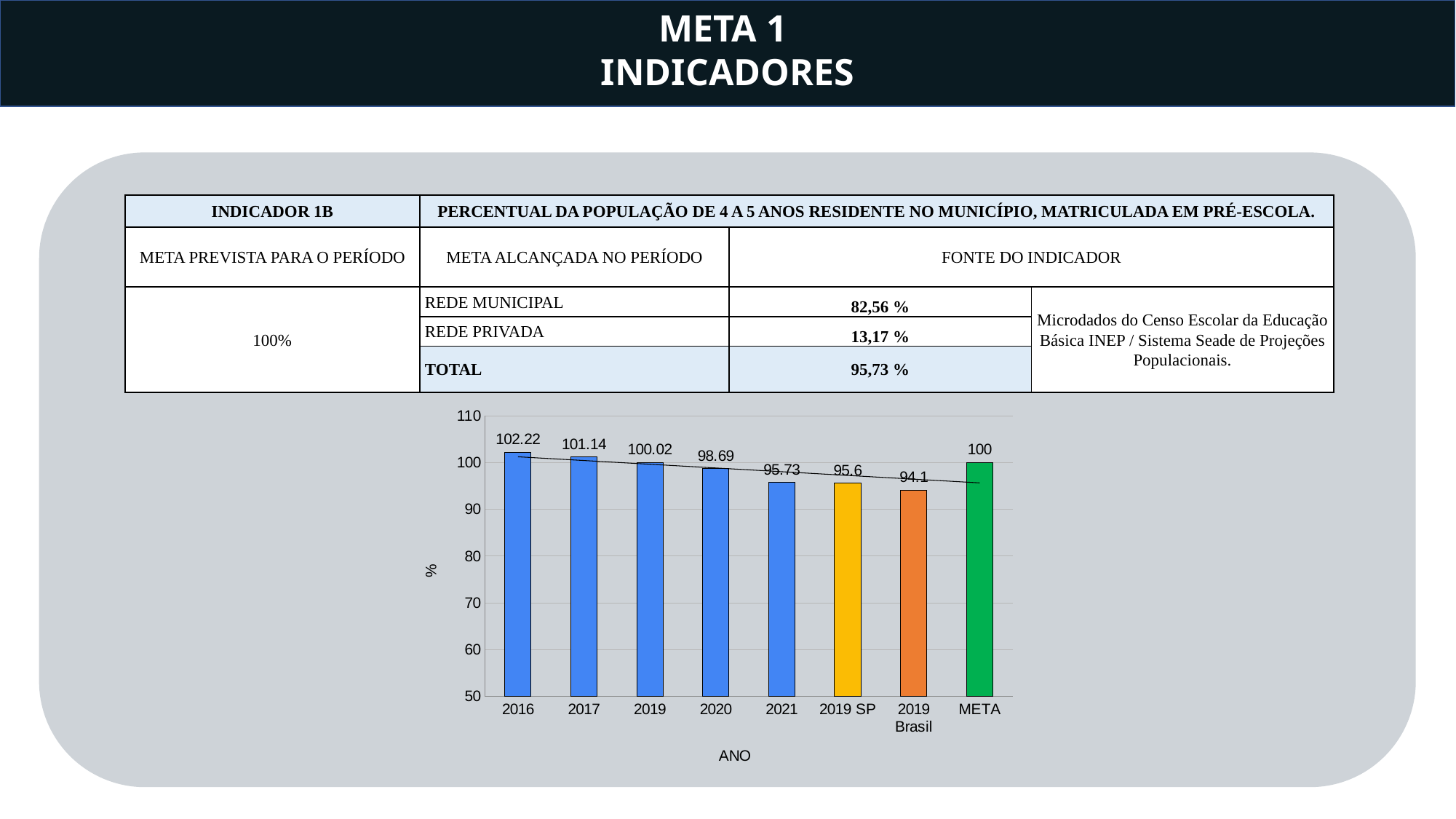
What type of chart is shown on the slide? bar chart What is the value for 2016 in the chart? 102.22 What is the difference between the META value and the 2019 Brasil value? 5.9 Which category has the highest value in the chart? 2016 Do the values for the years 2016 through 2021 rise or fall along the x axis? fall What is the value for 2019 SP in the chart? 95.6 How many bars are plotted in the chart? 8 What is the value for 2021 in the chart? 95.73 What is the value for 2019 Brasil in the chart? 94.1 Which category has the lowest value in the chart? 2019 Brasil What is the difference between the values for 2016 and 2021? 6.49 Which is larger, the value for 2020 or the value for 2019 SP? 2020